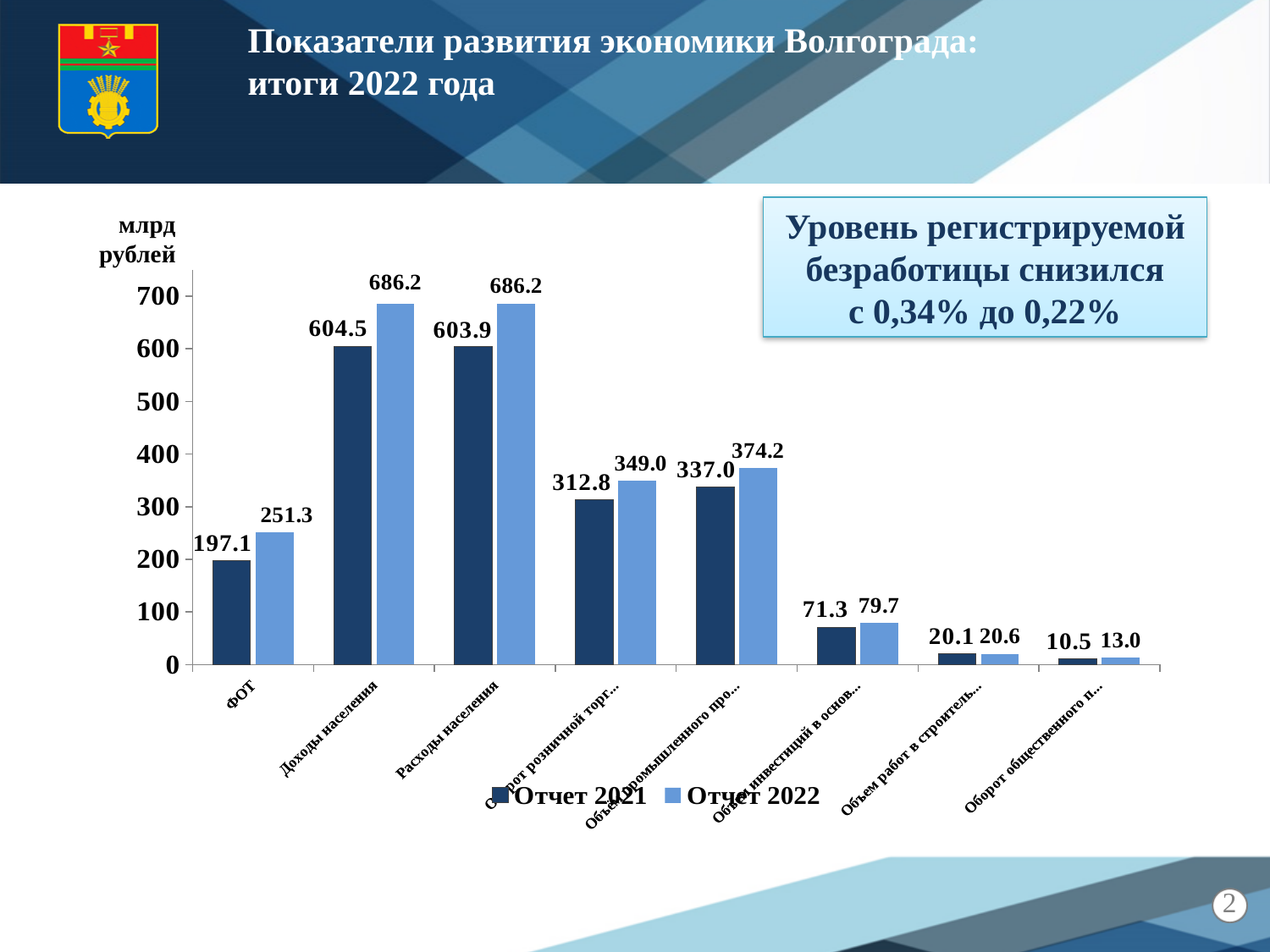
Which category has the highest value in the Отчет 2021 series? Доходы населения By how much did the value for ФОТ increase from Отчет 2021 to Отчет 2022? 54.2 What kind of chart is shown on the slide? Bar chart What unit is shown on the vertical axis of the chart? млрд рублей Which is larger in the Отчет 2021 series: ФОТ or Расходы населения? Расходы населения How many categories are shown on the x axis? 8 What is the value for ФОТ in the Отчет 2021 series? 197.1 What is the value for Расходы населения in the Отчет 2021 series? 603.9 What is the difference between the Отчет 2022 and Отчет 2021 values for Доходы населения? 81.7 What is the value for Доходы населения in the Отчет 2022 series? 686.2 How many series does the legend list? 2 What is the value for ФОТ in the Отчет 2022 series? 251.3